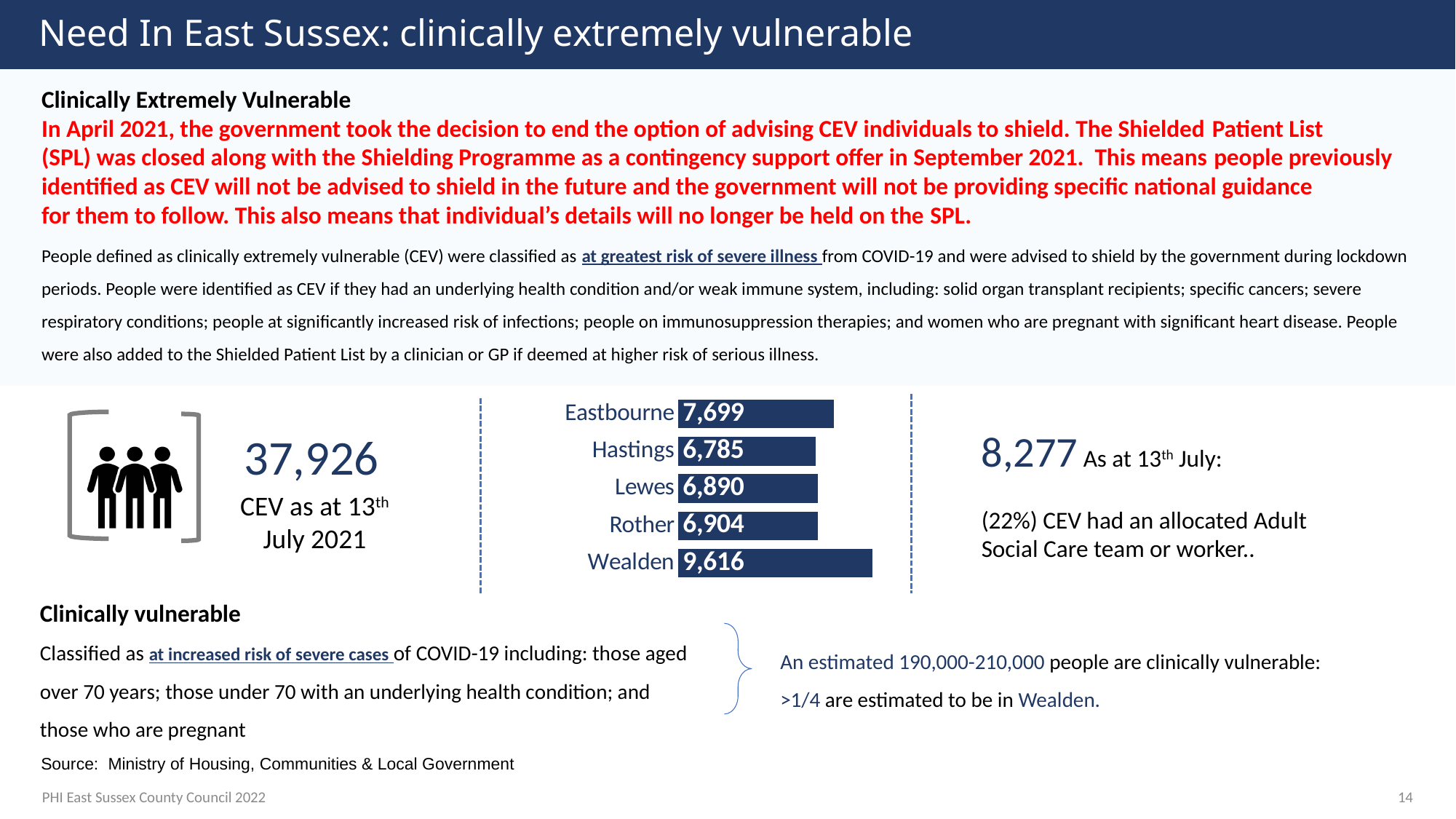
Which district has the highest value in the bar chart? Wealden What is the value for Wealden in the bar chart? 9,616 What is the value for Rother in the bar chart? 6,904 Which district has the lowest value in the bar chart? Hastings What is the difference between the values for Wealden and Eastbourne in the bar chart? 1,917 How many districts are shown in the bar chart? 5 What is the difference between the values for Eastbourne and Hastings in the bar chart? 914 Which has a larger value in the bar chart, Eastbourne or Lewes? Eastbourne What is the value for Eastbourne in the bar chart? 7,699 What is the value for Hastings in the bar chart? 6,785 What colour are the bars in the district chart? Dark blue What kind of chart is used to show the district values? Bar chart